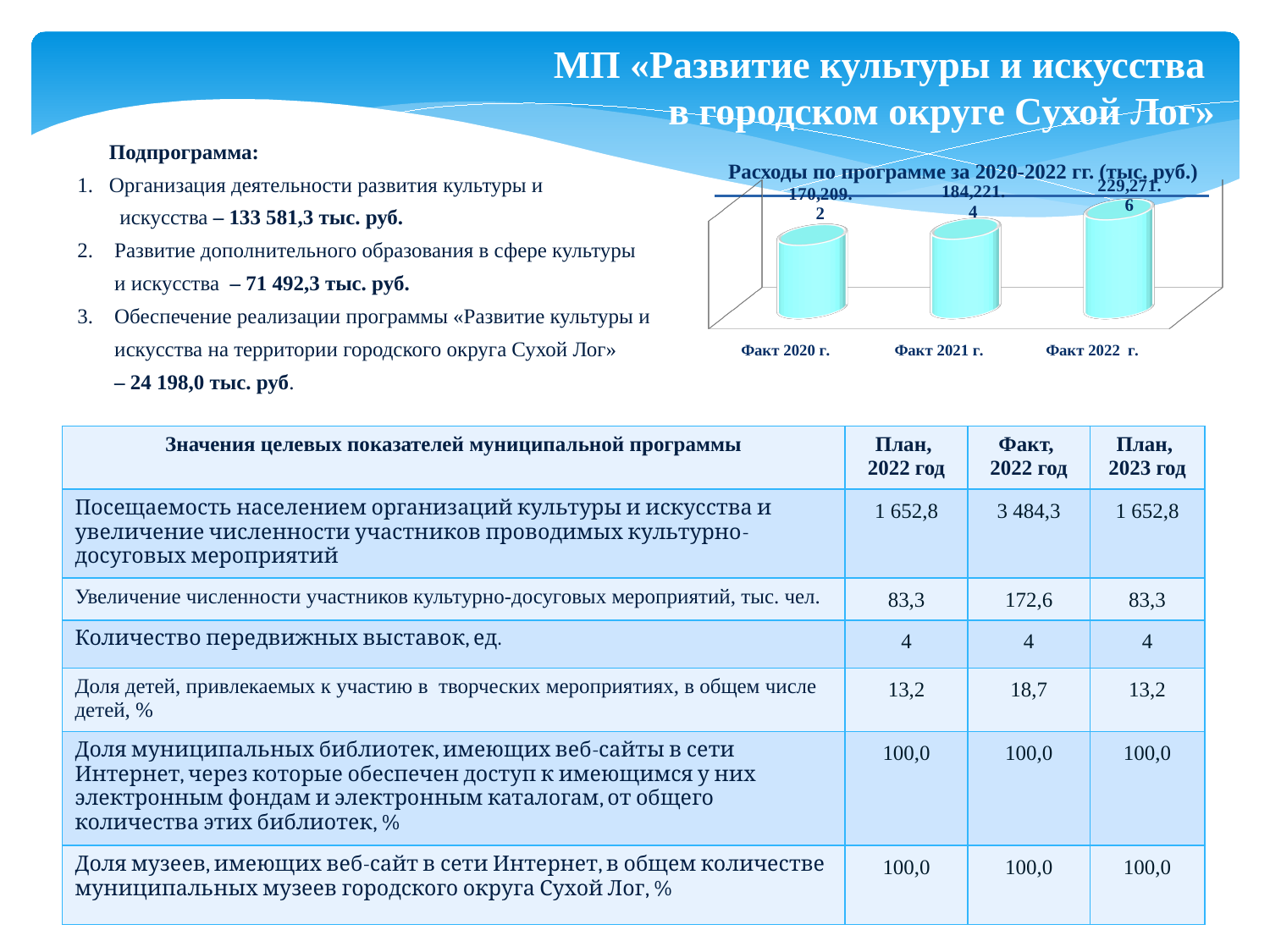
How many categories are shown in the chart? 3 What is the value for Факт 2021 г. in the chart? 184,221.4 Do the values rise or fall from Факт 2020 г. to Факт 2022 г.? rise What is the value for Факт 2022 г. in the chart? 229,271.6 What kind of chart is shown on the slide? bar chart Which is larger, the value for Факт 2021 г. or Факт 2022 г.? Факт 2022 г. What is the difference between the values for Факт 2021 г. and Факт 2020 г.? 14,012.2 What is the title of the chart? Расходы по программе за 2020-2022 гг. (тыс. руб.) What is the difference between the values for Факт 2022 г. and Факт 2020 г.? 59,062.4 Which category has the highest value in the chart? Факт 2022 г. What is the value for Факт 2020 г. in the chart? 170,209.2 Which category has the lowest value in the chart? Факт 2020 г.